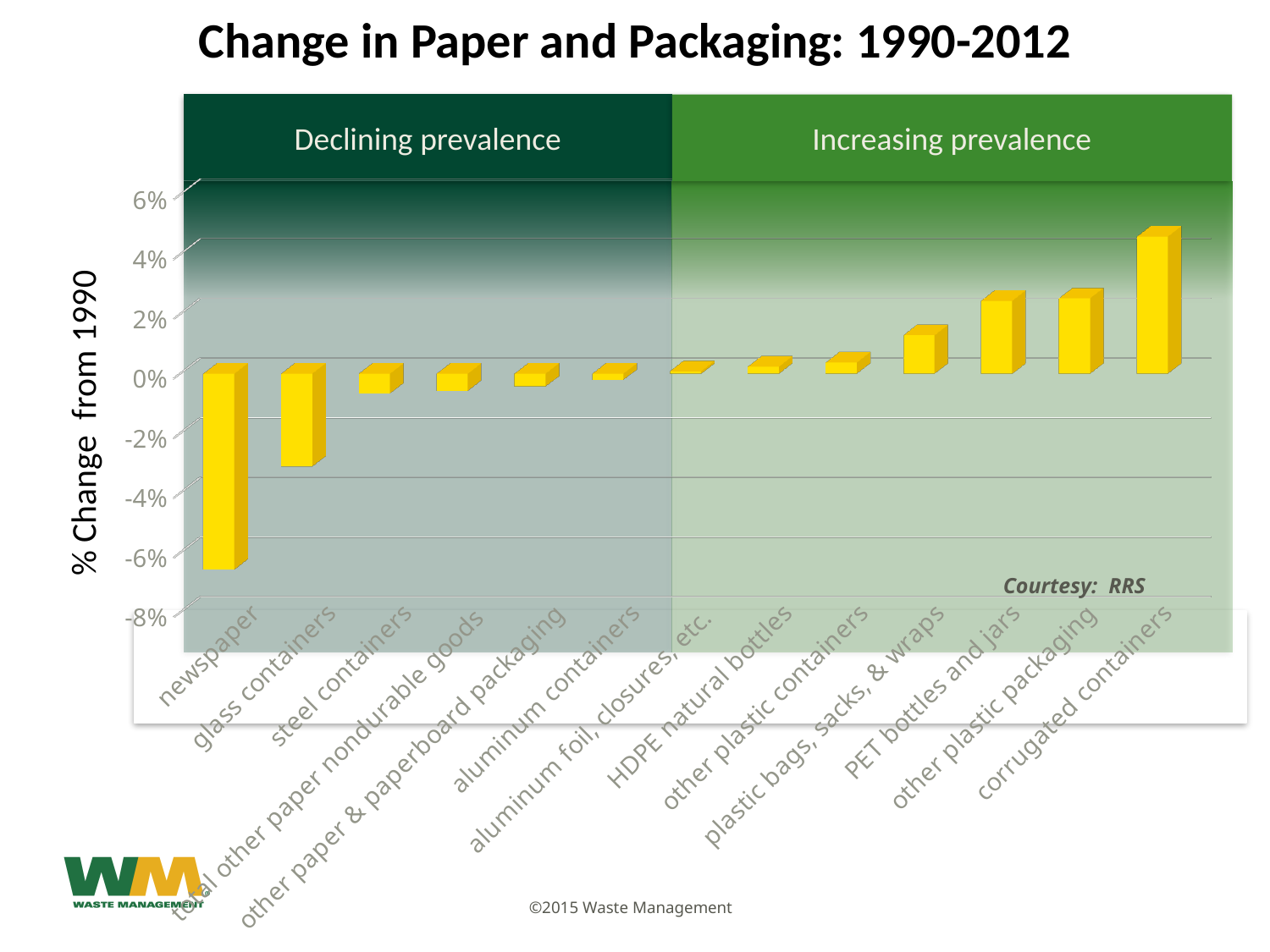
What is the title of the chart? Change in Paper and Packaging: 1990-2012 What kind of chart is shown on the slide? bar chart Is the value for plastic bags, sacks, & wraps greater or less than 2%? less Is the value for newspaper greater or less than -4%? less Do the values generally rise or fall moving left to right along the x axis? rise How many categories are plotted on the chart? 13 Is the value for glass containers greater or less than -2%? less Which has the larger decline, newspaper or glass containers? newspaper Which category has the highest value on the chart? corrugated containers What is the label on the vertical axis? % Change from 1990 Which category has the lowest value on the chart? newspaper